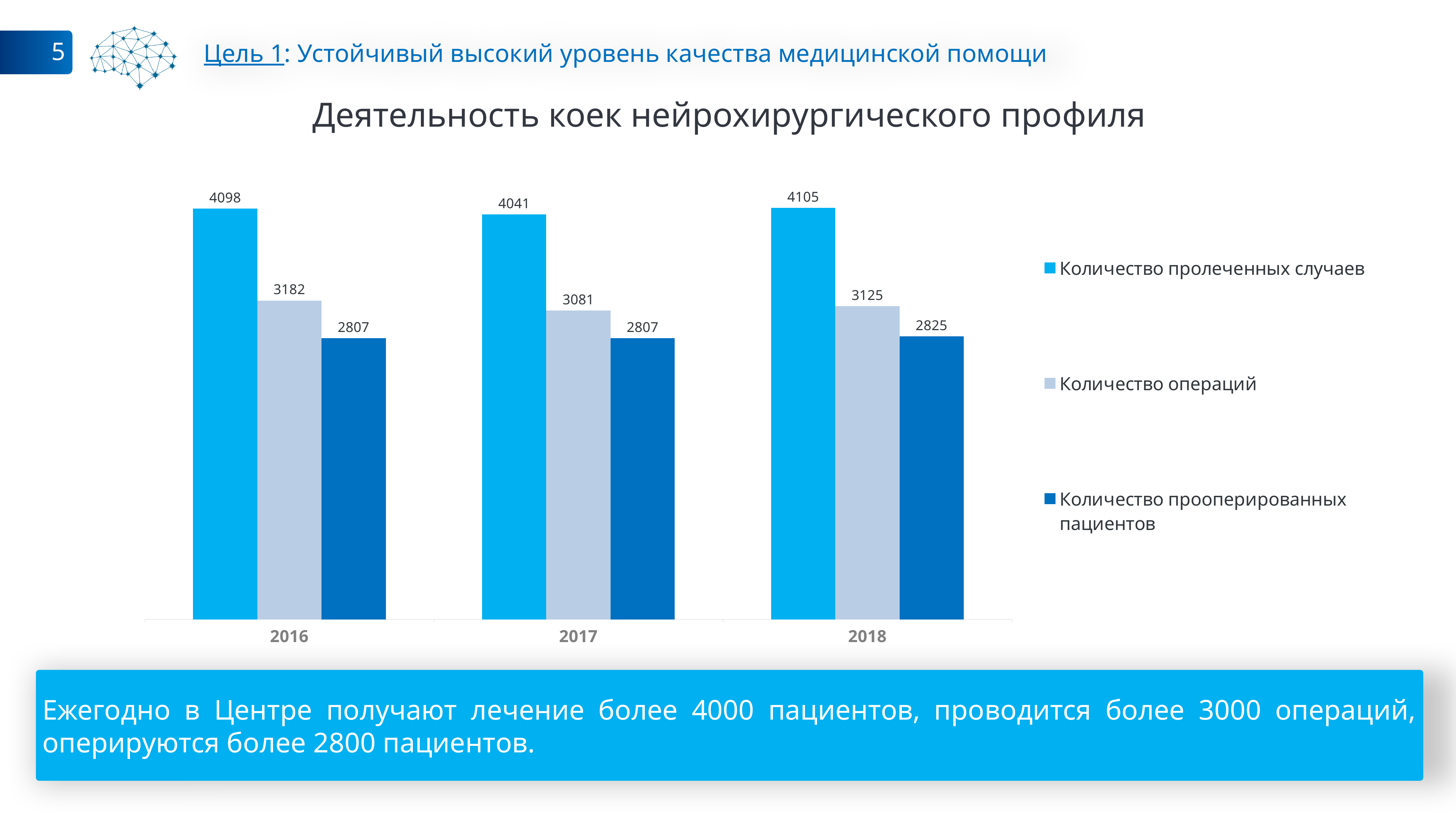
What is the difference between "Количество пролеченных случаев" and "Количество операций" in 2016? 916 In which year is "Количество пролеченных случаев" highest? 2018 Which is larger: "Количество пролеченных случаев" in 2016 or in 2017? 2016 What is the value of "Количество пролеченных случаев" for 2016? 4098 How many series does the legend list? 3 What is the title of the chart? Деятельность коек нейрохирургического профиля What is the value of "Количество операций" for 2017? 3081 How many years are shown on the x axis? 3 What is the difference between "Количество операций" in 2018 and in 2017? 44 What is the value of "Количество прооперированных пациентов" for 2018? 2825 What kind of chart is shown on the slide? Bar chart In which year is "Количество операций" lowest? 2017